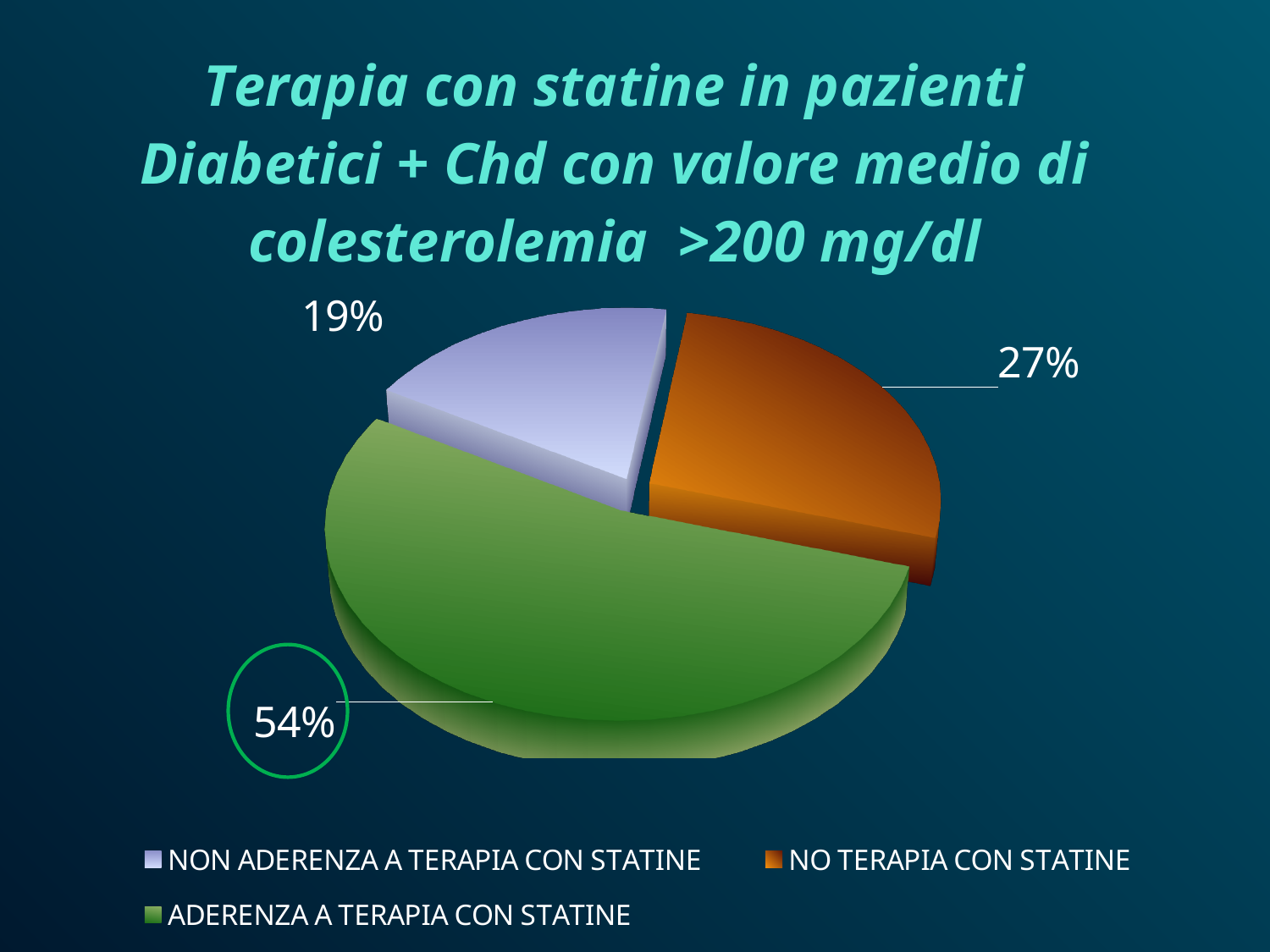
What is the difference in percentage points between ADERENZA A TERAPIA CON STATINE and NO TERAPIA CON STATINE? 27 What percentage is shown for NO TERAPIA CON STATINE? 27% What percentage is shown for NON ADERENZA A TERAPIA CON STATINE? 19% Which is larger: the share for NO TERAPIA CON STATINE or the share for NON ADERENZA A TERAPIA CON STATINE? NO TERAPIA CON STATINE What is the difference in percentage points between NO TERAPIA CON STATINE and NON ADERENZA A TERAPIA CON STATINE? 8 What type of chart is shown on the slide? Pie chart Which slice is highlighted with a circle around its data label? ADERENZA A TERAPIA CON STATINE (54%) How many slices does the pie chart have? 3 Which colour represents NO TERAPIA CON STATINE in the legend? Orange What percentage is shown for ADERENZA A TERAPIA CON STATINE? 54% Which category has the largest share of the pie? ADERENZA A TERAPIA CON STATINE Which category has the smallest share of the pie? NON ADERENZA A TERAPIA CON STATINE